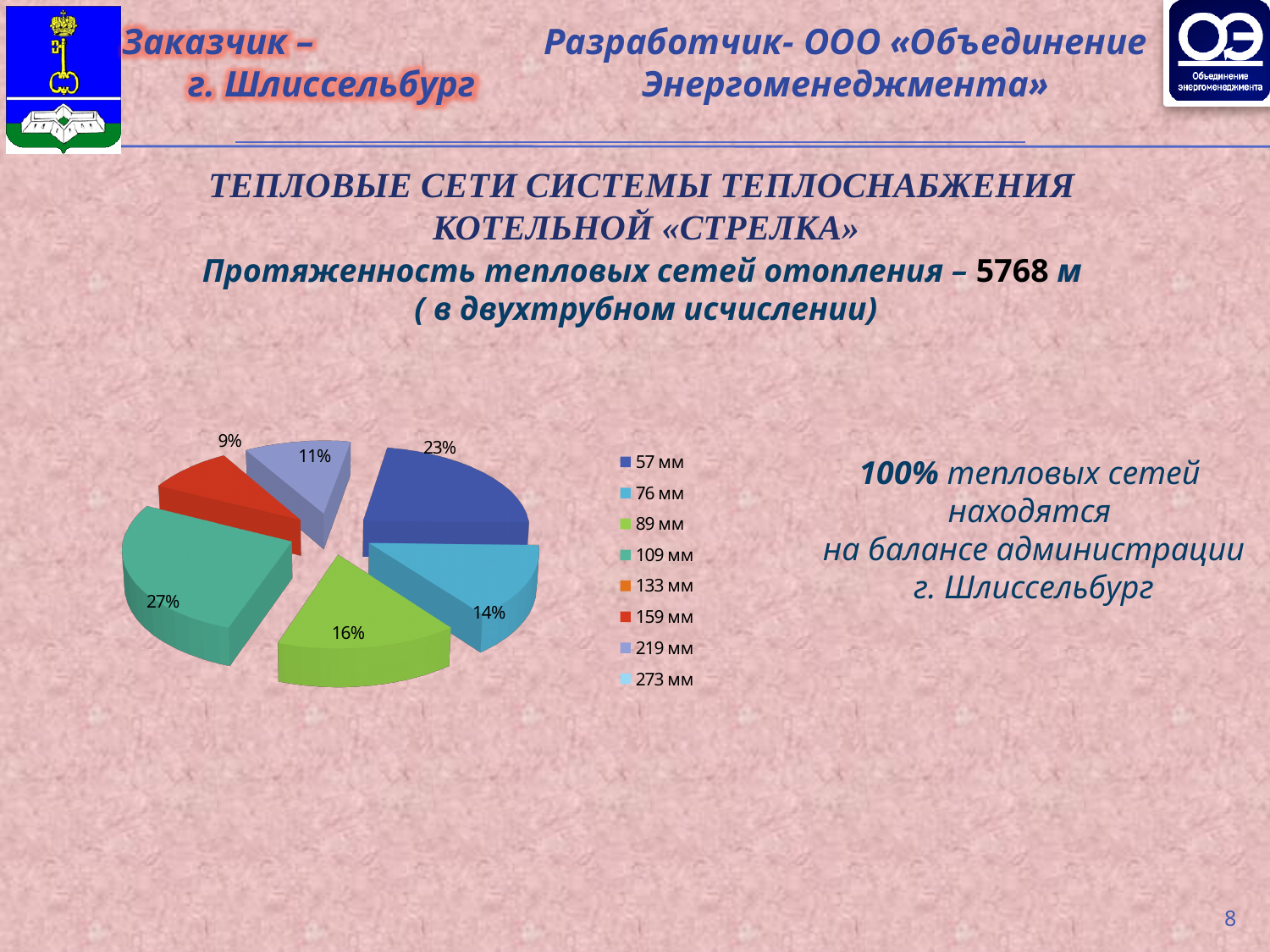
What share of the pie does the 219 мм slice have? 11% What share of the pie does the 109 мм slice have? 27% What share of the pie does the 57 мм slice have? 23% Which pipe diameter has the largest share of the pie? 109 мм Which slice is larger, 89 мм or 76 мм? 89 мм What is the difference in percentage points between the 109 мм slice and the 57 мм slice? 4 What kind of chart is shown on the slide? pie chart How many entries does the legend list? 8 Which of the labelled slices has the smallest share of the pie? 159 мм